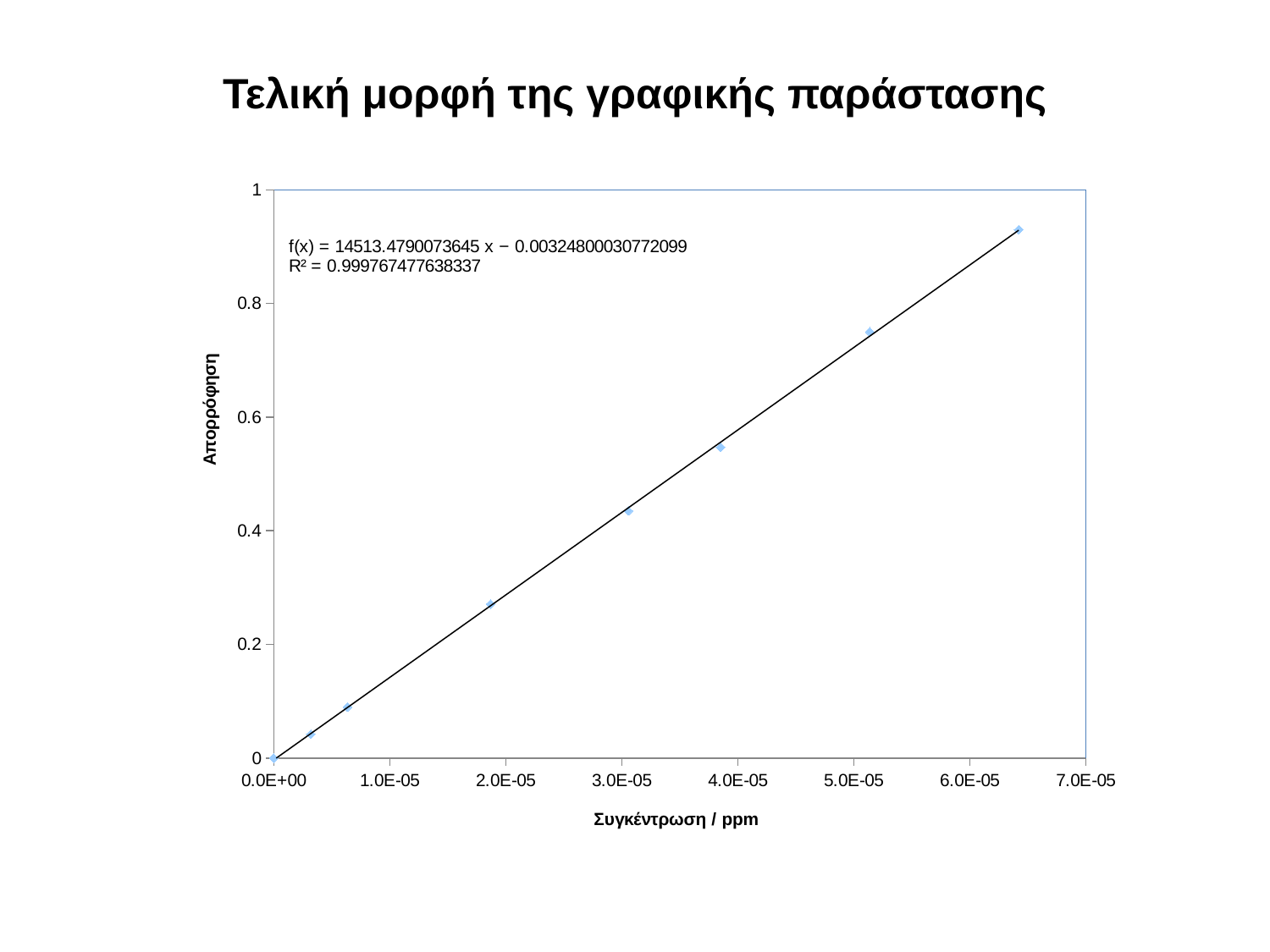
Is the absorbance value for the point near 6.4E-05 ppm greater or less than 0.8? greater Is the absorbance value for the point near 1.9E-05 ppm greater or less than 0.2? greater What is the R² value shown on the chart? 0.999767477638337 What is the label of the x axis? Συγκέντρωση / ppm Which plotted point has the highest absorbance, the one near 6.4E-05 ppm or the one near 5.1E-05 ppm? the one near 6.4E-05 ppm What kind of chart is shown on the slide? scatter chart Is the absorbance value for the point near 3.9E-05 ppm greater or less than 0.6? less Do the plotted values rise or fall as concentration increases along the x axis? rise